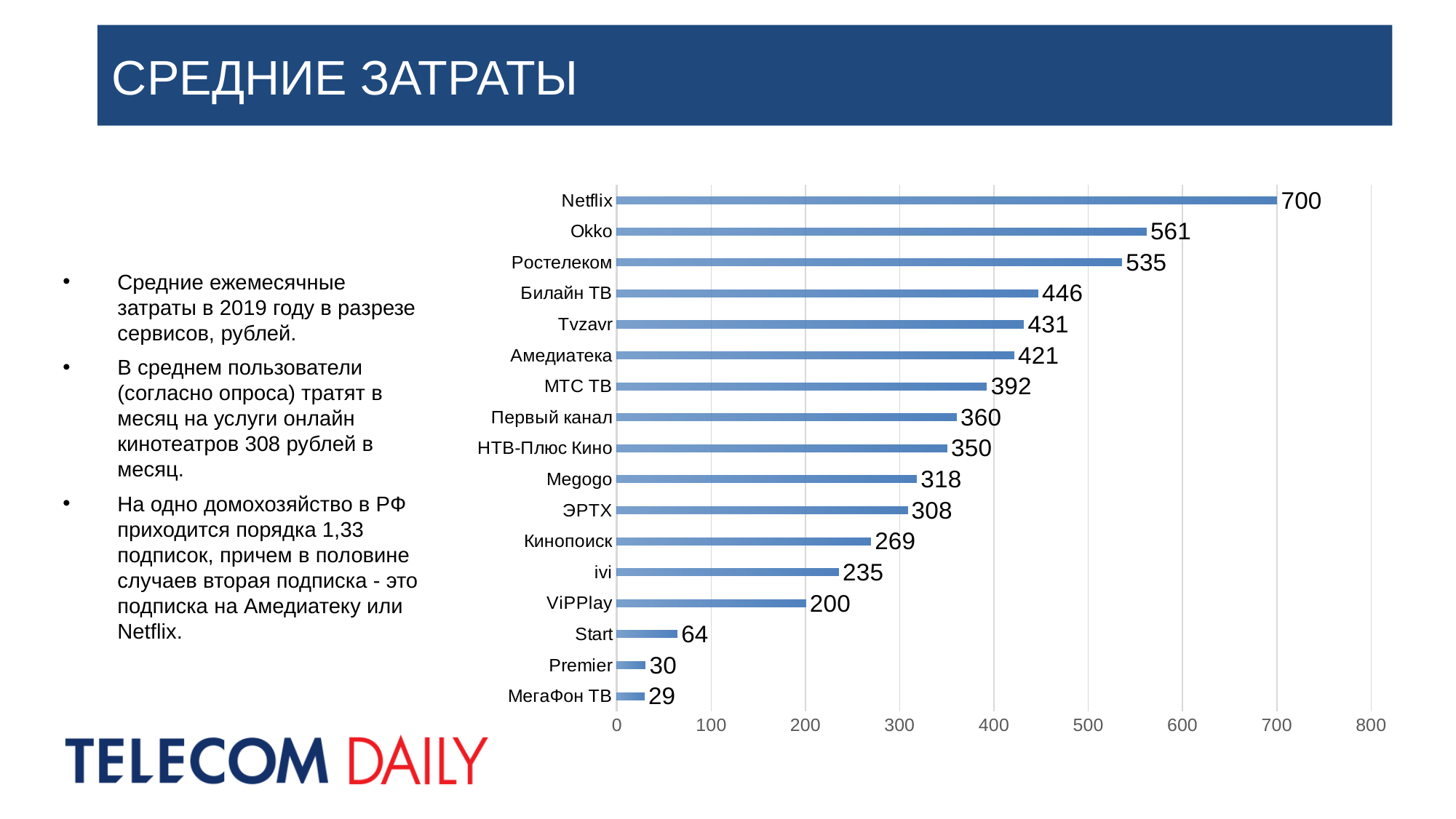
What is the value for ViPPlay? 200 Which is larger, the value for Кинопоиск or the value for Megogo? Megogo What is the difference between the values for Okko and Ростелеком? 26 What is the value for Амедиатека? 421 How many categories are shown in the chart? 17 What is the value for Netflix? 700 Which category has the highest value? Netflix Which category has the lowest value? МегаФон ТВ What kind of chart is shown on the slide? Bar chart Which is larger, the value for Билайн ТВ or the value for Tvzavr? Билайн ТВ What is the difference between the values for Netflix and ivi? 465 What is the maximum value shown on the horizontal axis? 800